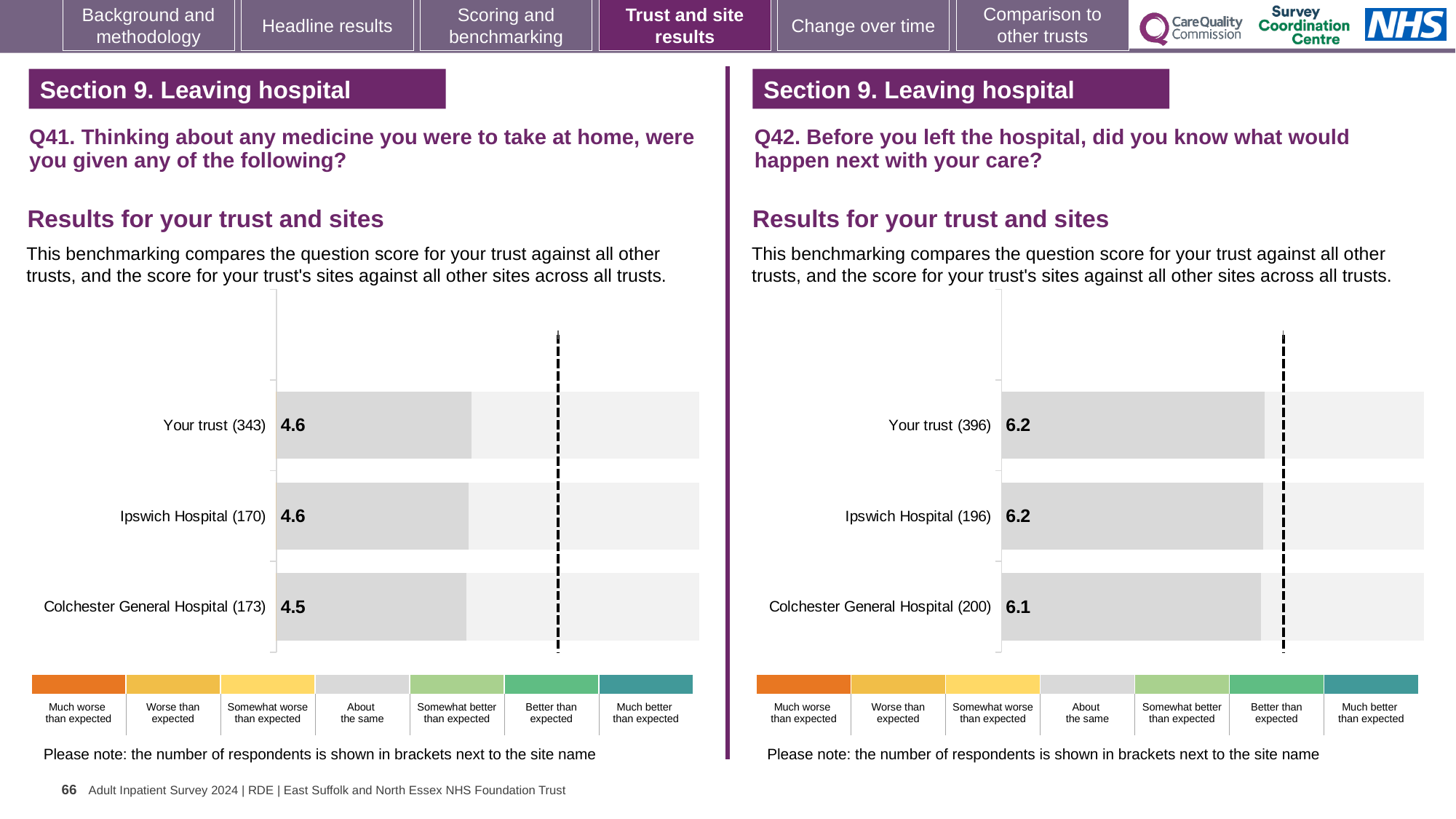
In the Q42 chart on the right, is the score for Ipswich Hospital larger or smaller than the score for Colchester General Hospital? larger What type of chart is used for the Q42 results on the right? bar chart In the Q42 chart on the right, what is the score for Colchester General Hospital? 6.1 In the Q41 chart on the left, which site has the lowest score? Colchester General Hospital How many bars are plotted in the Q41 chart on the left? 3 In the Q42 chart on the right, which site has the lowest score? Colchester General Hospital In the Q41 chart on the left, what is the difference between the scores for Ipswich Hospital and Colchester General Hospital? 0.1 In the Q41 chart on the left, what is the score for Colchester General Hospital? 4.5 In the Q42 chart on the right, how many respondents are shown in brackets for Your trust? 396 In the Q42 chart on the right, what is the difference between the scores for Your trust and Colchester General Hospital? 0.1 In the Q42 chart on the right, what is the score for Ipswich Hospital? 6.2 In the Q41 chart on the left, what is the score for Your trust? 4.6